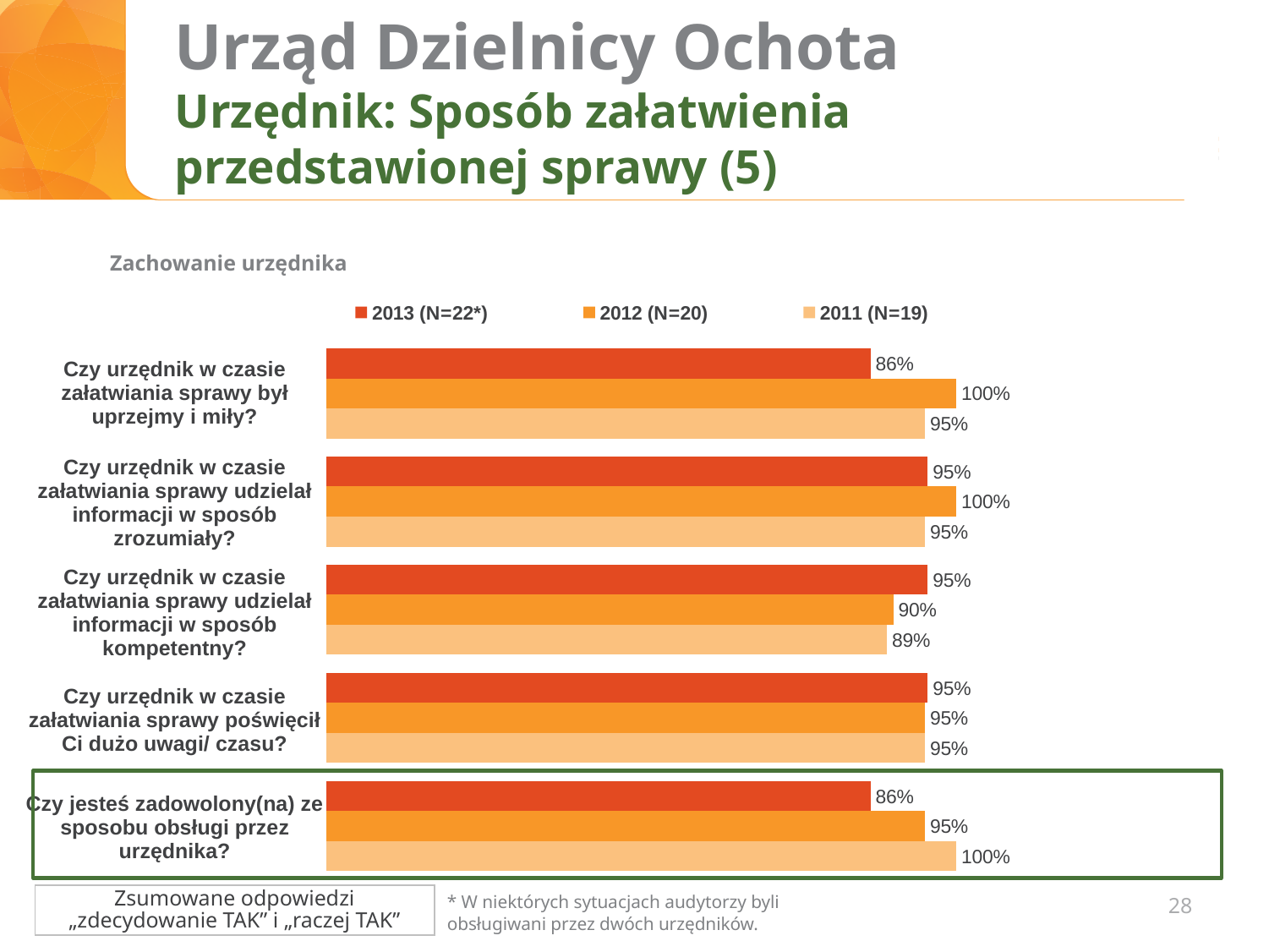
What is the 2012 (N=20) value for "Czy urzędnik w czasie załatwiania sprawy udzielał informacji w sposób zrozumiały?"? 100% For "Czy jesteś zadowolony(na) ze sposobu obsługi przez urzędnika?", which is larger: the 2012 (N=20) value or the 2011 (N=19) value? 2011 (N=19) What is the title shown above the chart? Zachowanie urzędnika What is the 2011 (N=19) value for "Czy jesteś zadowolony(na) ze sposobu obsługi przez urzędnika?"? 100% What is the difference between the 2012 (N=20) and 2013 (N=22*) values for "Czy urzędnik w czasie załatwiania sprawy był uprzejmy i miły?"? 14% What is the 2013 (N=22*) value for "Czy urzędnik w czasie załatwiania sprawy był uprzejmy i miły?"? 86% How many series does the legend list? 3 How many question categories are plotted in the chart? 5 Which year has the highest value for "Czy urzędnik w czasie załatwiania sprawy udzielał informacji w sposób kompetentny?"? 2013 (N=22*) What is the 2011 (N=19) value for "Czy urzędnik w czasie załatwiania sprawy udzielał informacji w sposób kompetentny?"? 89% What kind of chart is shown on the slide? bar chart Which year has the lowest value for "Czy jesteś zadowolony(na) ze sposobu obsługi przez urzędnika?"? 2013 (N=22*)